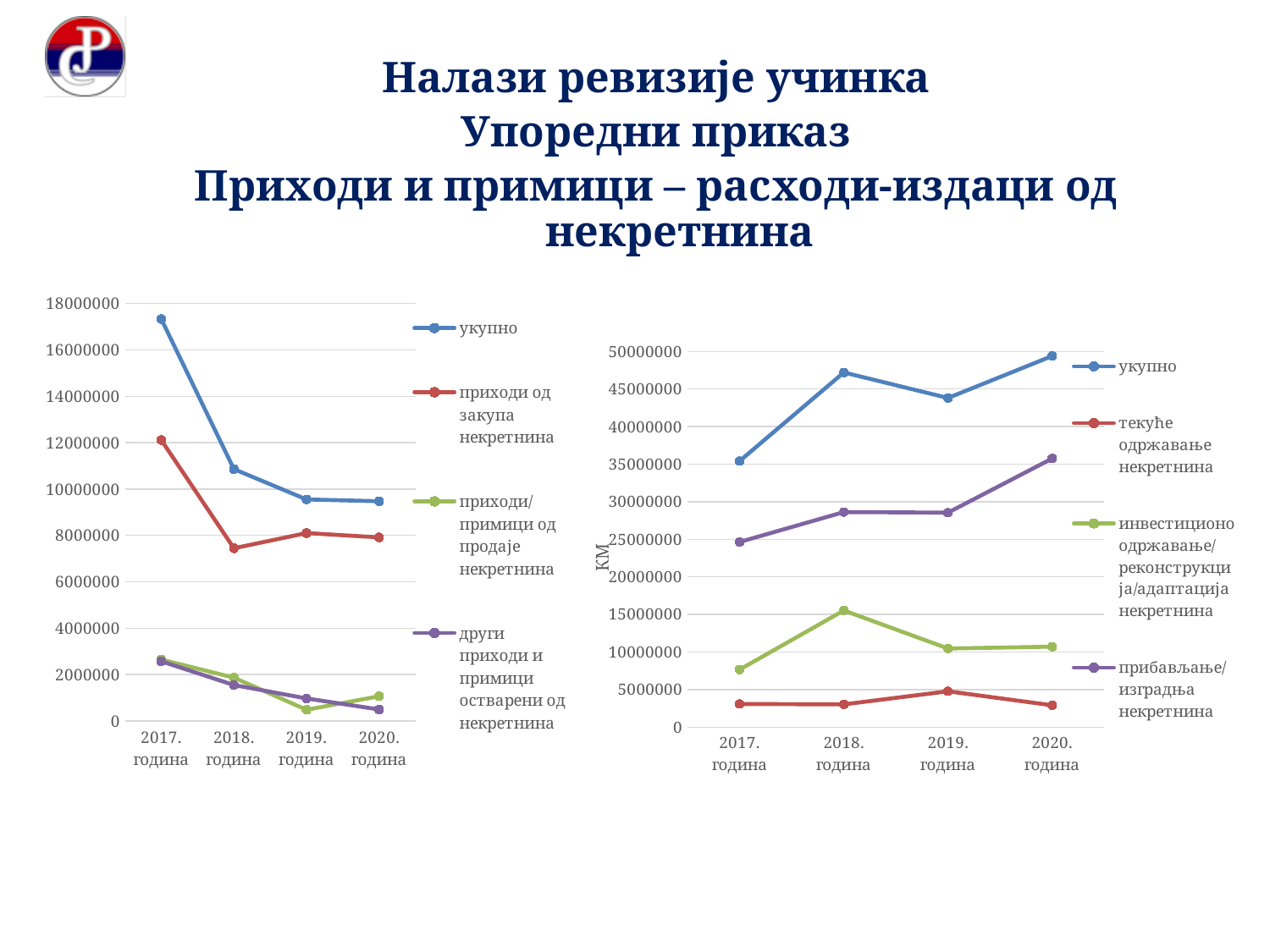
In the left-hand chart, is the value of 'укупно' for 2017. година greater or less than 16000000? greater In the right-hand chart, which is larger in 2018. година: 'инвестиционо одржавање/реконструкција/адаптација некретнина' or 'текуће одржавање некретнина'? инвестиционо одржавање/реконструкција/адаптација некретнина What label is shown on the vertical axis of the right-hand chart? КМ In the left-hand chart, does the 'укупно' series rise or fall from 2017. година to 2018. година? fall What kind of chart is the chart on the left of the slide? line chart In the left-hand chart, in which year is the 'приходи од закупа некретнина' series lowest? 2018. година How many series does the legend of the right-hand chart list? 4 In the right-hand chart, is the value of 'текуће одржавање некретнина' for 2019. година greater or less than 10000000? less How many years are shown on the x axis of the left-hand chart? 4 In the right-hand chart, does the 'укупно' series rise or fall from 2017. година to 2020. година overall? rise In the right-hand chart, in which year is the 'укупно' series highest? 2020. година In the right-hand chart, in which year is the 'инвестиционо одржавање/реконструкција/адаптација некретнина' series highest? 2018. година